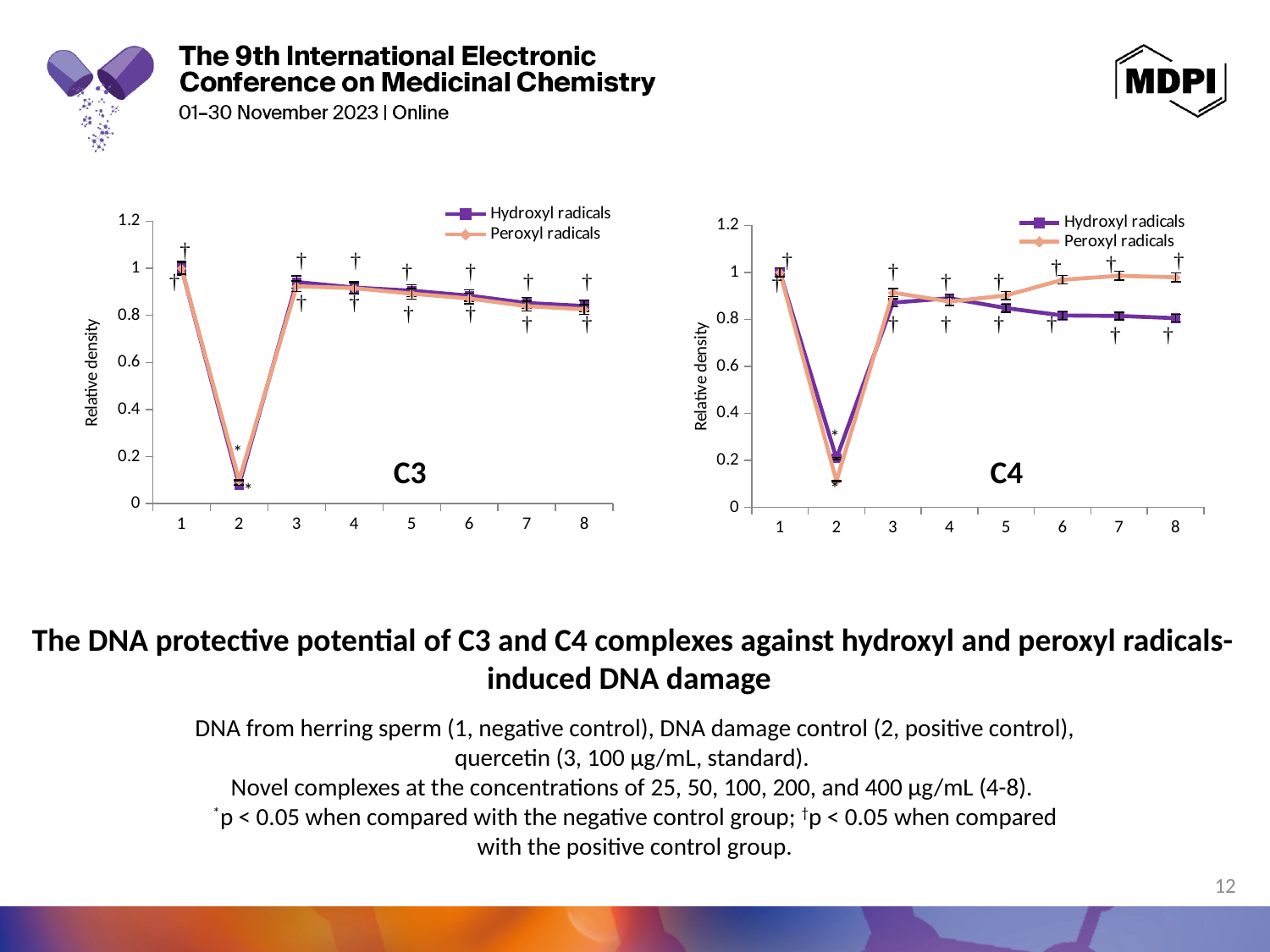
What is the label of the y axis on the C3 chart? Relative density In the C3 chart, do the hydroxyl radicals values rise or fall from category 3 to category 8? fall How many points are plotted along the x axis of the C3 chart for each series? 8 In the C4 chart, is the hydroxyl radicals value at category 2 greater or less than 0.4? less In the C4 chart, which x-axis category has the lowest relative density for peroxyl radicals? 2 Which series in the C4 chart is drawn in purple? Hydroxyl radicals What type of chart is the C3 chart? line chart In the C3 chart, is the hydroxyl radicals value at category 2 greater or less than 0.2? less In the C3 chart, which x-axis category has the lowest relative density for hydroxyl radicals? 2 In the C4 chart, which series has the larger value at category 8, hydroxyl radicals or peroxyl radicals? Peroxyl radicals How many series does the legend of the C4 chart list? 2 In the C4 chart, is the peroxyl radicals value at category 7 greater or less than 0.8? greater